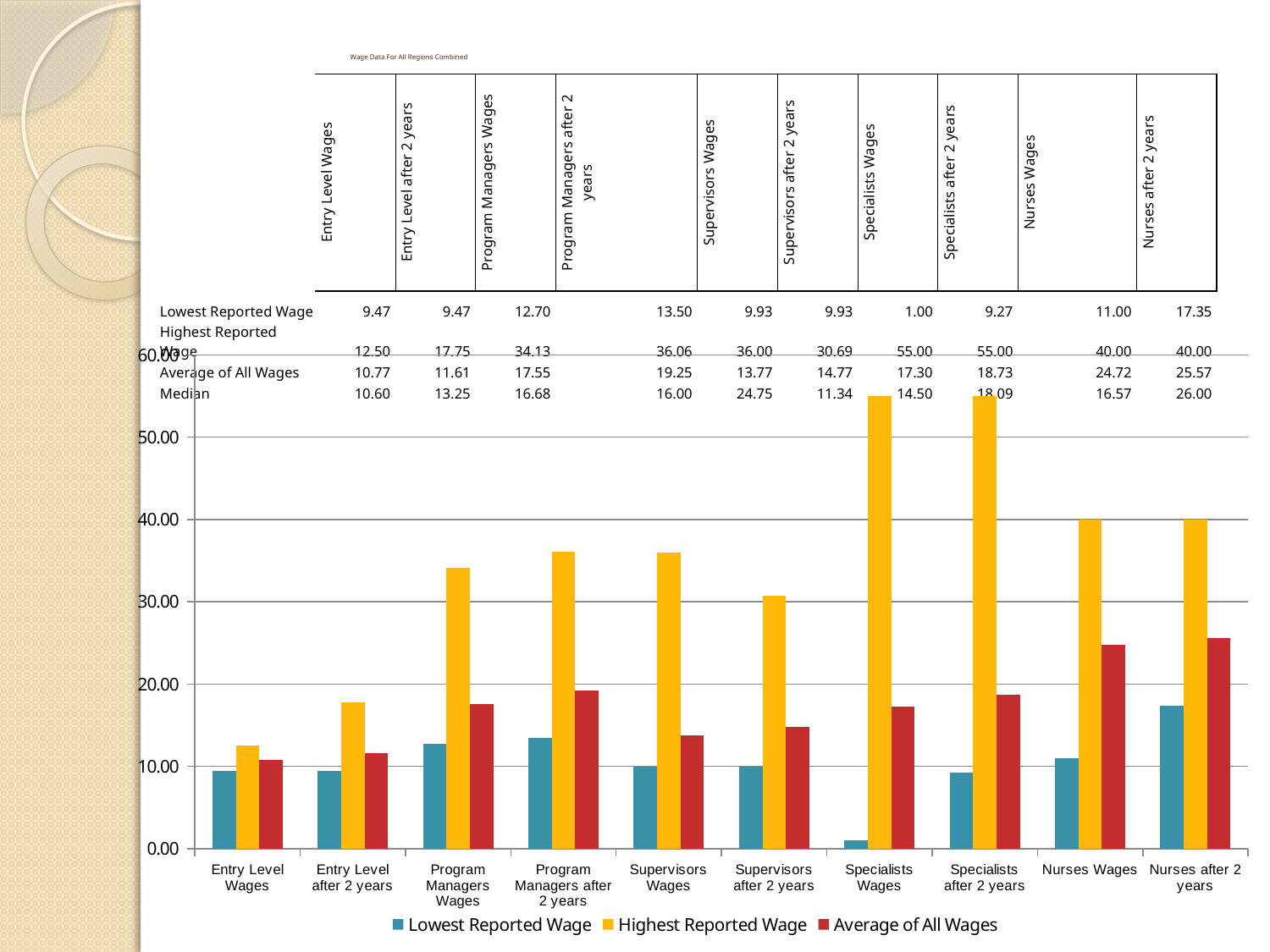
What is the Average of All Wages for Program Managers after 2 years? 19.25 Does the Average of All Wages rise or fall from Nurses Wages to Nurses after 2 years? rise Which is larger, the Average of All Wages for Supervisors Wages or for Supervisors after 2 years? Supervisors after 2 years Which category has the lowest Lowest Reported Wage? Specialists Wages What is the Lowest Reported Wage for Nurses after 2 years? 17.35 What is the difference between the Highest Reported Wage and the Lowest Reported Wage for Entry Level Wages? 3.03 What kind of chart is shown on the slide? bar chart Is the Highest Reported Wage for Program Managers Wages greater or less than 30.00? greater Which colour represents the Highest Reported Wage series in the chart? yellow How many job categories are plotted along the x axis of the chart? 10 How many series does the chart legend list? 3 What is the Highest Reported Wage for Specialists Wages? 55.00